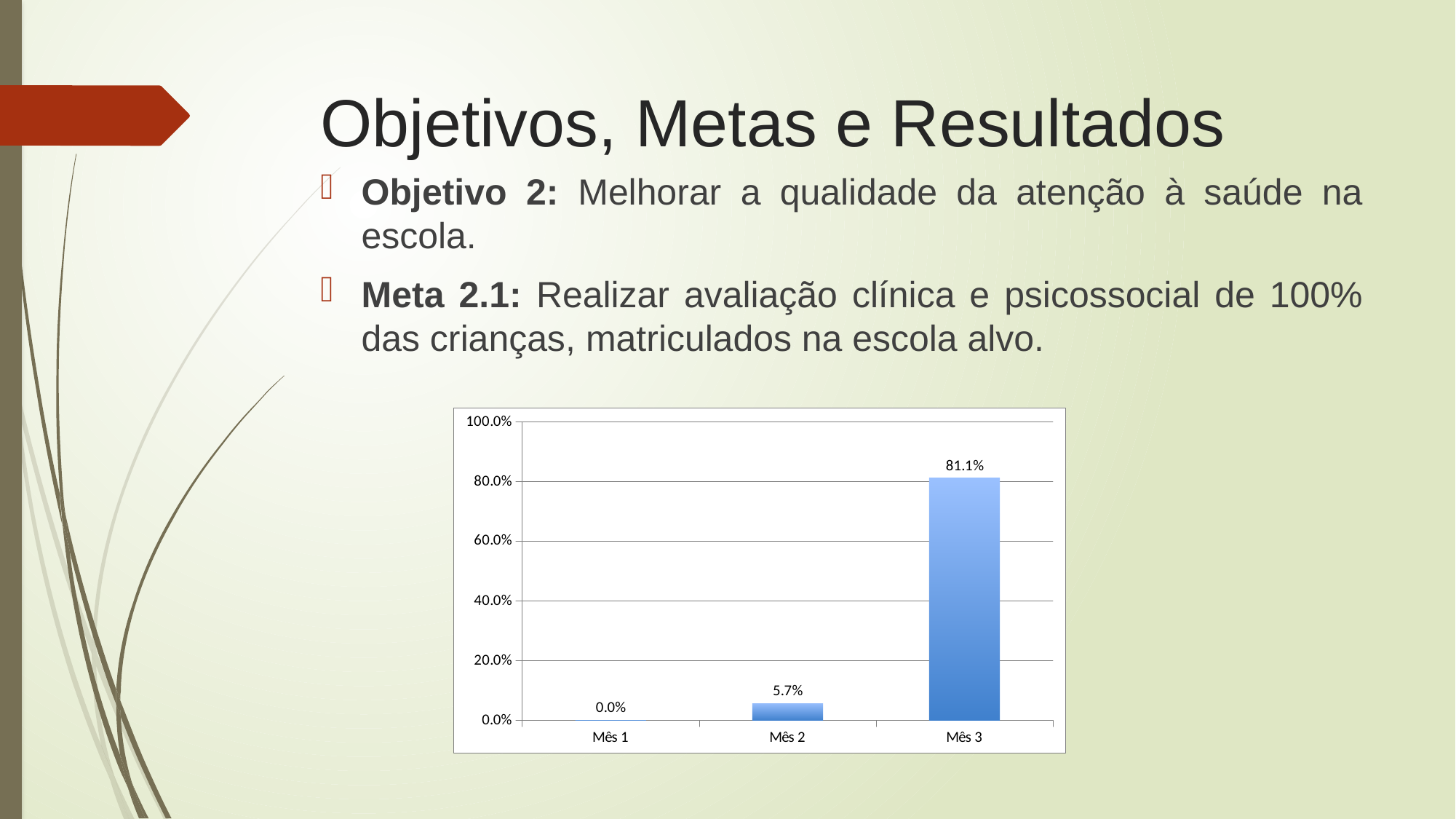
What kind of chart is shown on the slide? bar chart Which is larger, the value for Mês 2 or the value for Mês 3? Mês 3 What is the difference between the values for Mês 3 and Mês 2? 75.4% Which month has the lowest value? Mês 1 What is the value for Mês 1? 0.0% How many months are shown on the x axis? 3 Is the value for Mês 2 greater or less than 20.0%? less What is the value for Mês 3? 81.1% Do the values rise or fall from Mês 1 to Mês 3? rise Which month has the highest value? Mês 3 What is the value for Mês 2? 5.7% Is the value for Mês 3 greater or less than 80.0%? greater